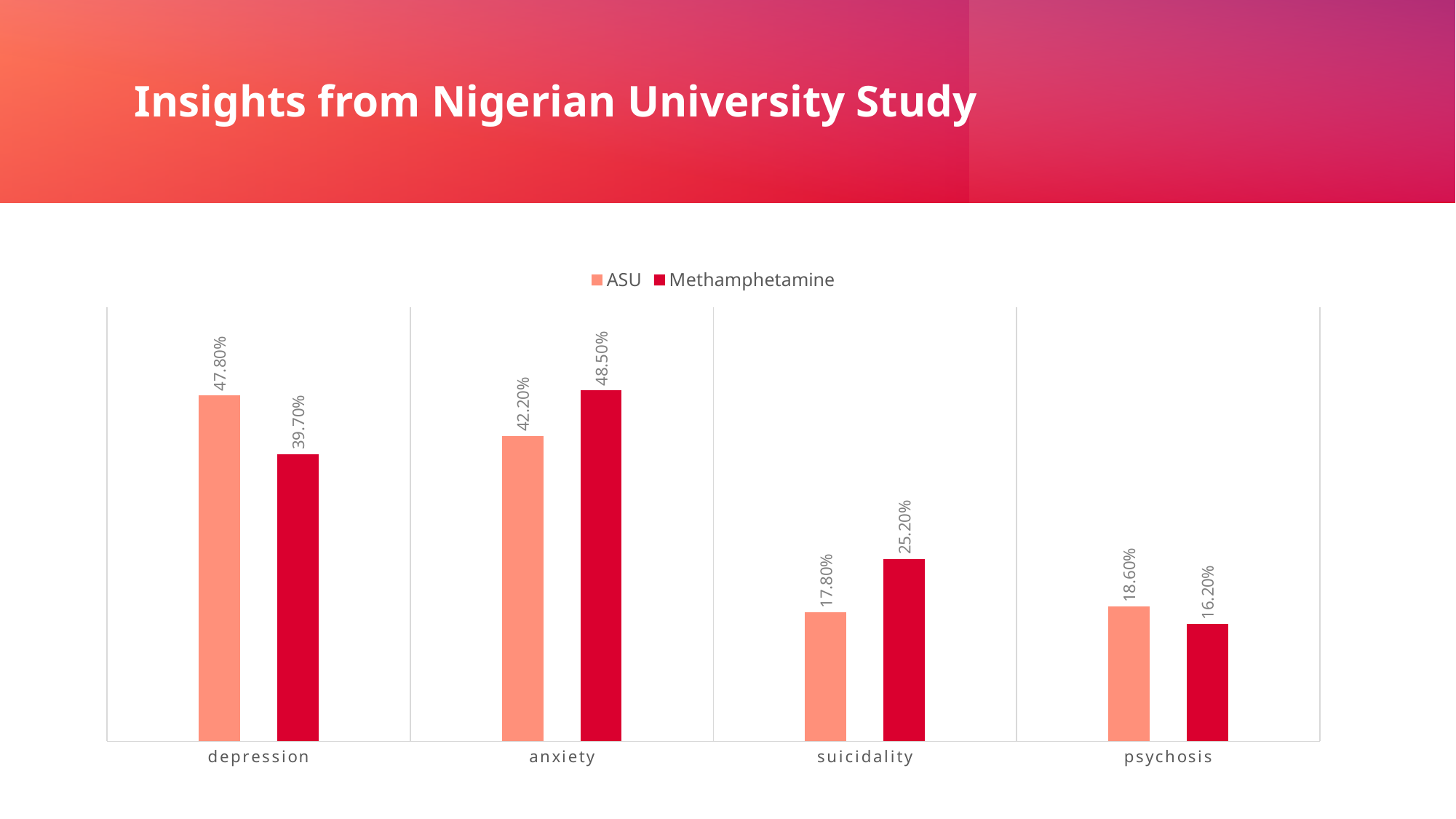
What kind of chart is shown on the slide? bar chart Which category has the lowest Methamphetamine value? psychosis How many series does the legend list? 2 What is the Methamphetamine value for suicidality? 25.20% Which is larger for suicidality, the ASU value or the Methamphetamine value? Methamphetamine Which category has the highest ASU value? depression What is the ASU value for depression? 47.80% What is the ASU value for psychosis? 18.60% What is the Methamphetamine value for anxiety? 48.50% What is the difference between the ASU and Methamphetamine values for depression? 8.10% How many categories are shown on the x axis? 4 What are the two series named in the legend? ASU and Methamphetamine